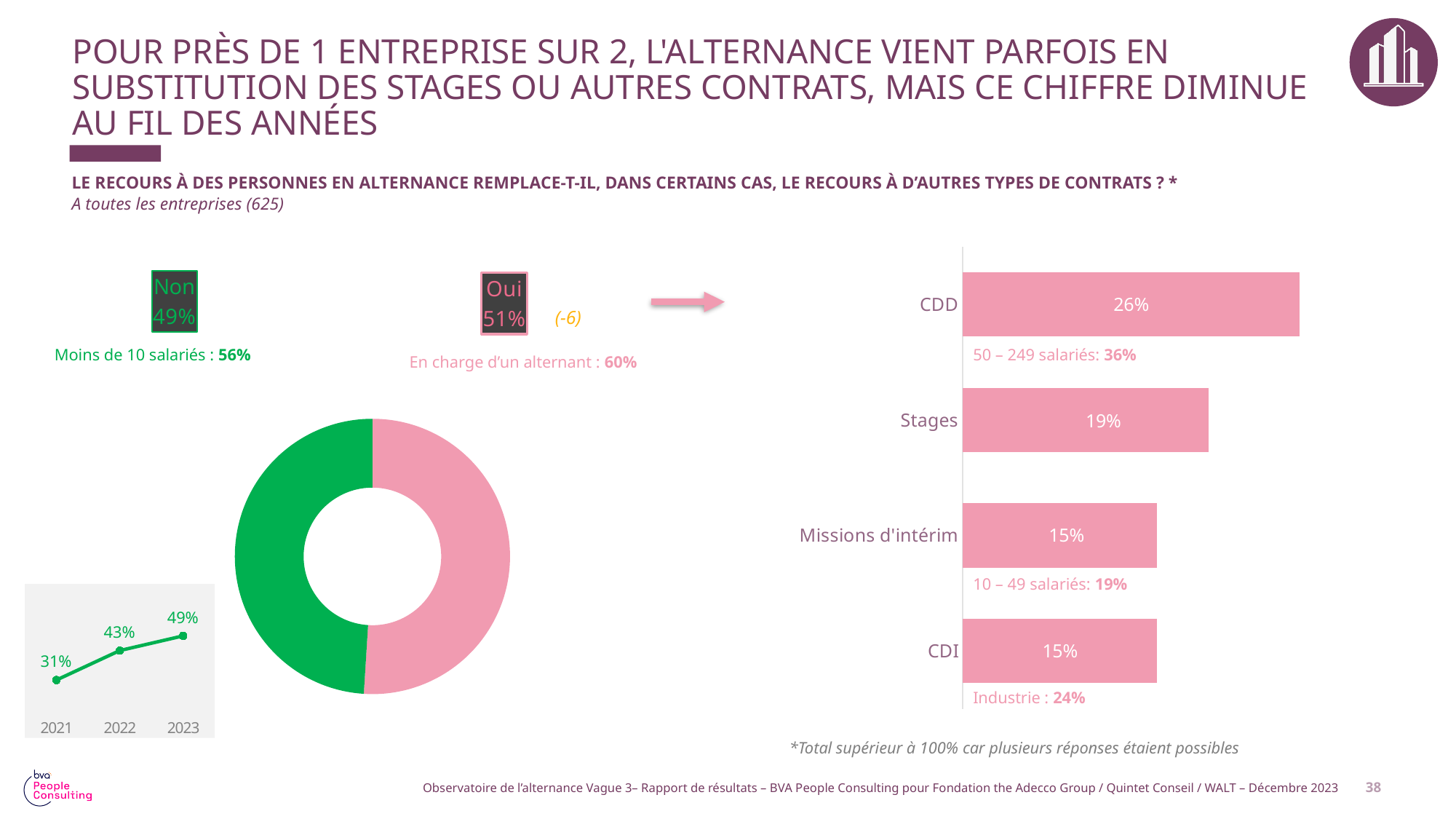
In the donut chart in the centre, what share is labelled 'Oui'? 51% In the horizontal bar chart on the right, which is larger, the value for Stages or the value for CDI? Stages In the horizontal bar chart on the right, which category has the highest value? CDD In the horizontal bar chart on the right, what is the value for Stages? 19% In the horizontal bar chart on the right, what is the difference between the values for CDD and Stages? 7% In the horizontal bar chart on the right, how many categories are shown? 4 What kind of chart is the chart on the right showing CDD, Stages, Missions d'intérim and CDI? Bar chart In the donut chart in the centre, what share is labelled 'Non'? 49% In the small line chart at the bottom left, do the values rise or fall from 2021 to 2023? Rise In the small line chart at the bottom left, what is the difference between the 2023 and 2021 values? 18% In the horizontal bar chart on the right, what is the value for CDD? 26% In the small line chart at the bottom left, what is the value for 2022? 43%